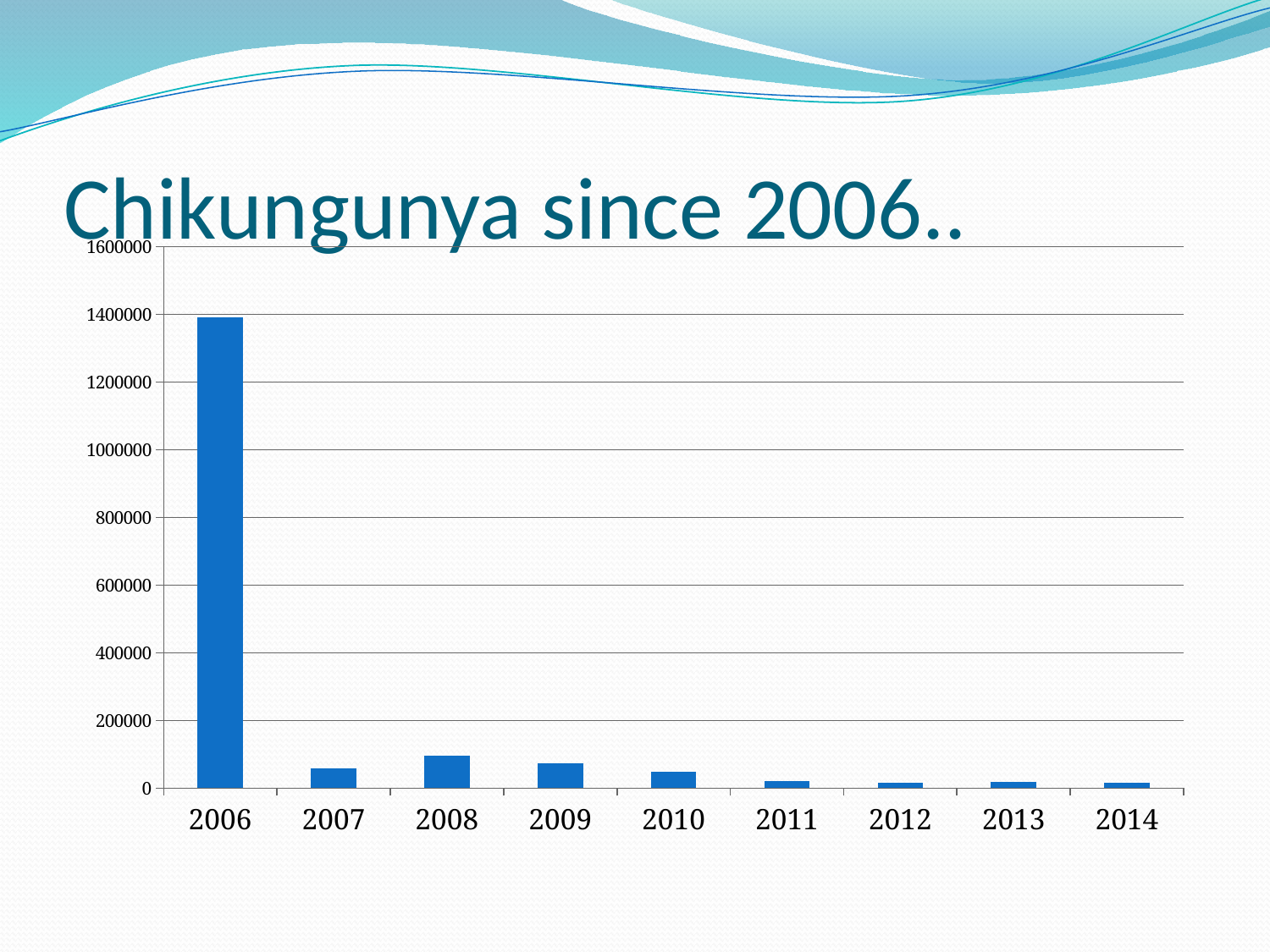
How many years are shown on the x axis of the chart? 9 Which is larger, the value for 2008 or the value for 2011? 2008 What kind of chart is shown on the slide? bar chart What is the title of the slide containing the chart? Chikungunya since 2006.. Which is larger, the value for 2006 or the value for 2007? 2006 Is the value for 2008 greater or less than 200000? less Is the value for 2007 greater or less than 200000? less Which is larger, the value for 2008 or the value for 2009? 2008 Which year has the highest bar in the chart? 2006 Overall, do the values rise or fall from 2006 to 2014? fall Is the value for 2006 greater or less than 1200000? greater